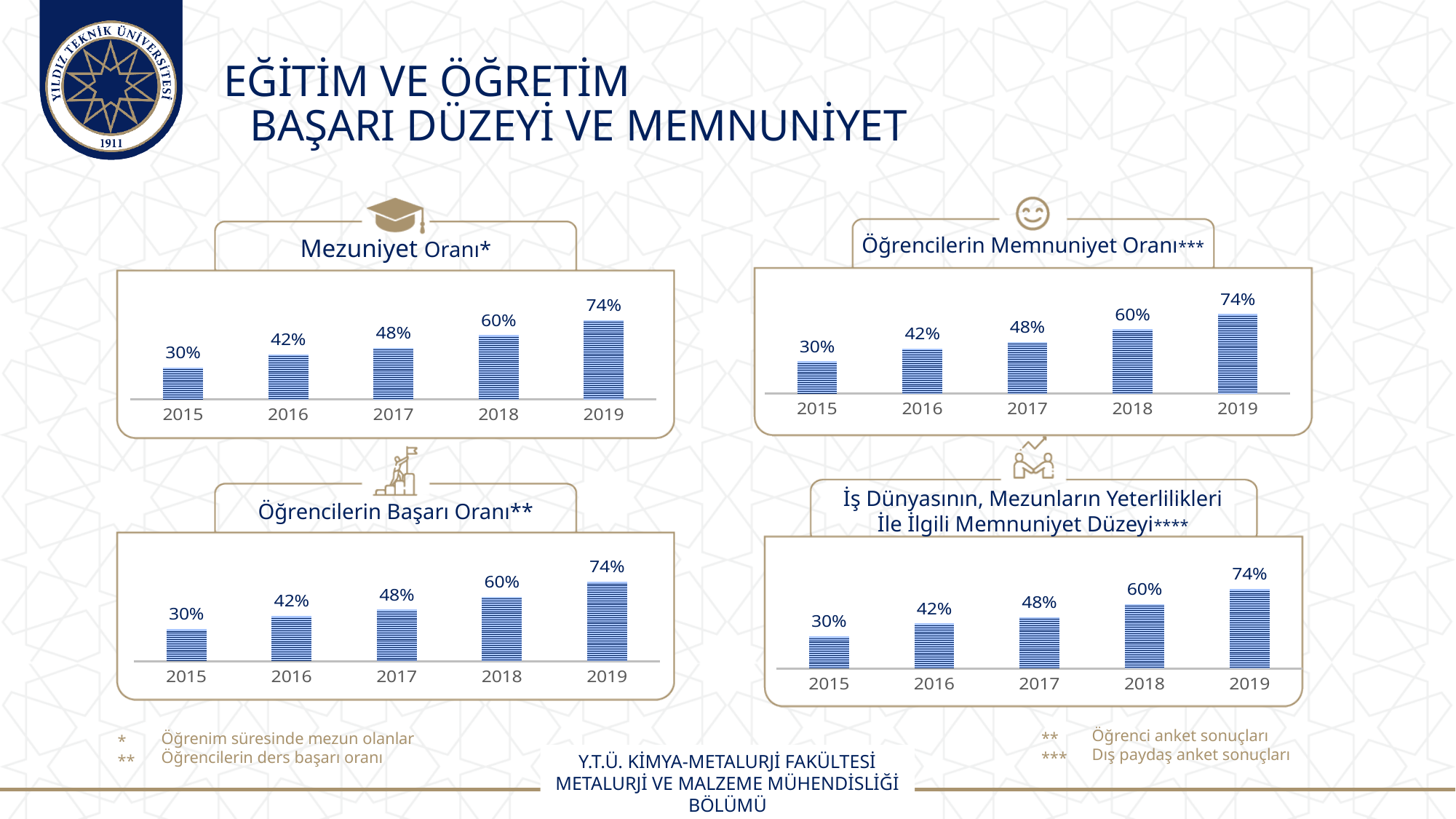
In the "Mezuniyet Oranı" chart, what is the value for 2015? 30% What kind of chart is the "Öğrencilerin Başarı Oranı" chart? bar chart In the "Mezuniyet Oranı" chart, which year has the highest value? 2019 In the "Öğrencilerin Başarı Oranı" chart, which year has the lowest value? 2015 In the "Öğrencilerin Başarı Oranı" chart, what is the value for 2018? 60% In the "Öğrencilerin Memnuniyet Oranı" chart, what is the value for 2017? 48% How many charts are shown on the slide? 4 In the "İş Dünyasının, Mezunların Yeterlilikleri İle İlgili Memnuniyet Düzeyi" chart, which is larger, the value for 2017 or the value for 2018? 2018 How many years are shown on the x axis of the "Mezuniyet Oranı" chart? 5 In the "Öğrencilerin Memnuniyet Oranı" chart, what is the difference between the values for 2019 and 2015? 44% In the "İş Dünyasının, Mezunların Yeterlilikleri İle İlgili Memnuniyet Düzeyi" chart, what is the value for 2016? 42% In the "Öğrencilerin Memnuniyet Oranı" chart, do the values rise or fall from 2015 to 2019? rise